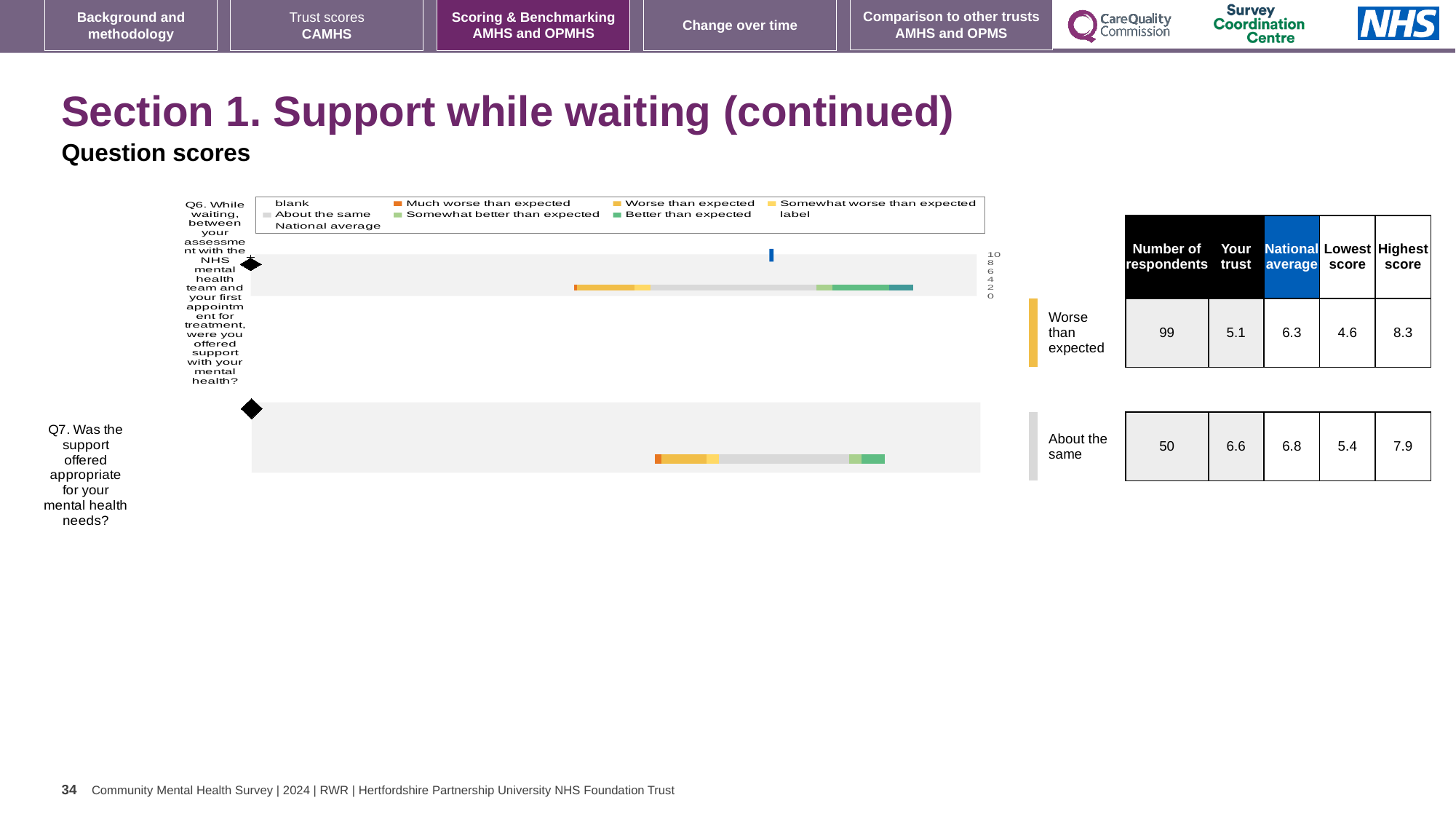
What does the blue marker in the chart represent, according to the legend? National average What is the national average score for Q7? 6.8 Which benchmark category is Q7 placed in? About the same What is the 'Your trust' score for Q6? 5.1 What kind of chart is shown on the slide? bar chart How many questions (categories) are plotted in the chart? 2 What is the difference between the highest score and the lowest score for Q7? 2.5 What is the 'Your trust' score for Q7? 6.6 How many respondents are shown for Q6? 99 For Q6, which is larger: the 'Your trust' score or the national average? National average Which colour in the legend represents 'Much worse than expected'? orange Which benchmark category is Q6 placed in? Worse than expected